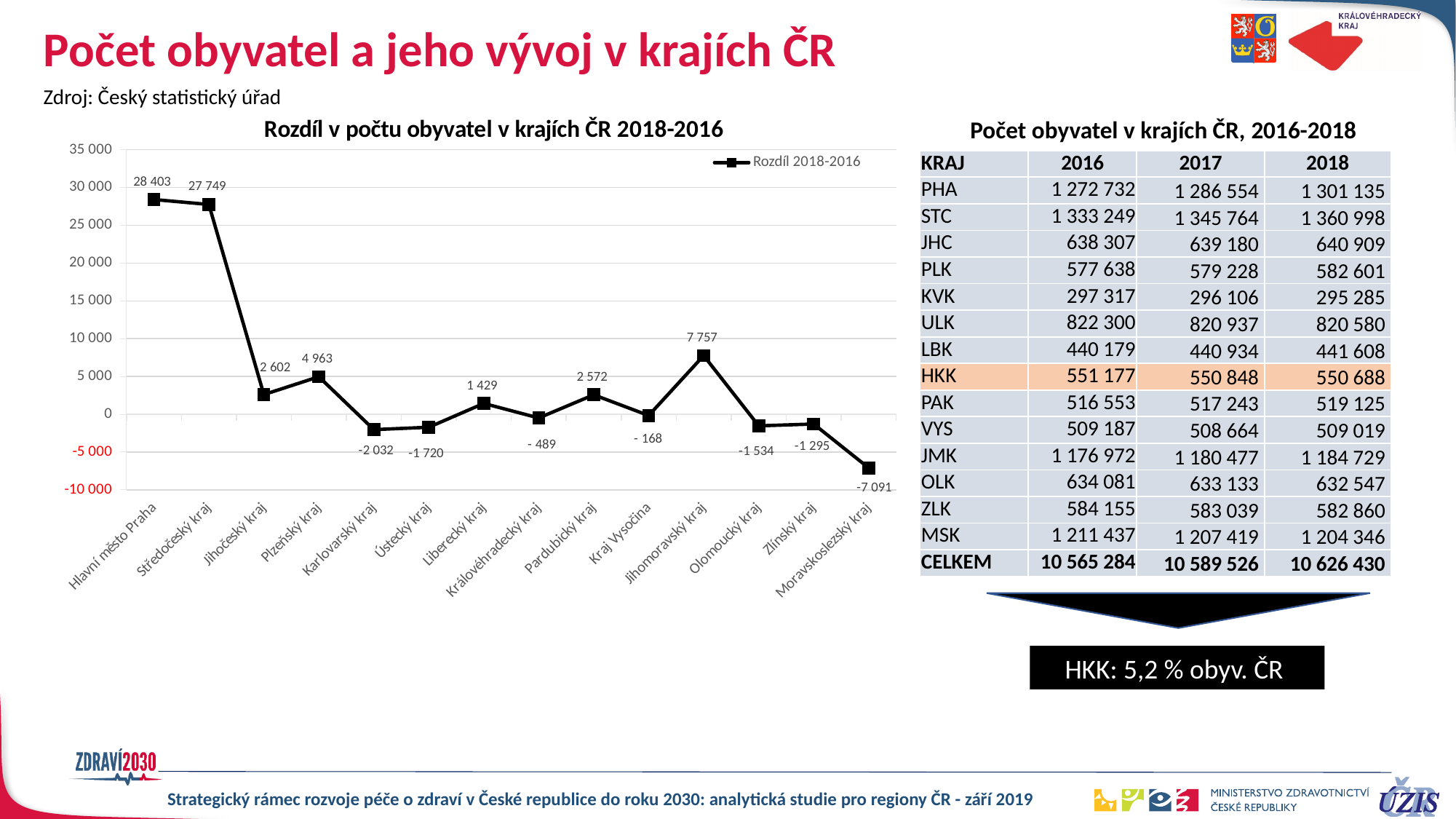
Which region has the lowest value in the chart? Moravskoslezský kraj Which has a larger value, Plzeňský kraj or Jihočeský kraj? Plzeňský kraj What is the title of the chart? Rozdíl v počtu obyvatel v krajích ČR 2018-2016 How many series does the chart legend list? 1 What type of chart is shown on the slide? line chart What is the difference between the values for Hlavní město Praha and Středočeský kraj? 654 How many regions are plotted in the chart? 14 What is the value for Hlavní město Praha in the chart? 28 403 What is the value for Jihomoravský kraj in the chart? 7 757 Which region has the highest value in the chart? Hlavní město Praha What is the value for Moravskoslezský kraj in the chart? -7 091 What is the value for Královéhradecký kraj in the chart? - 489